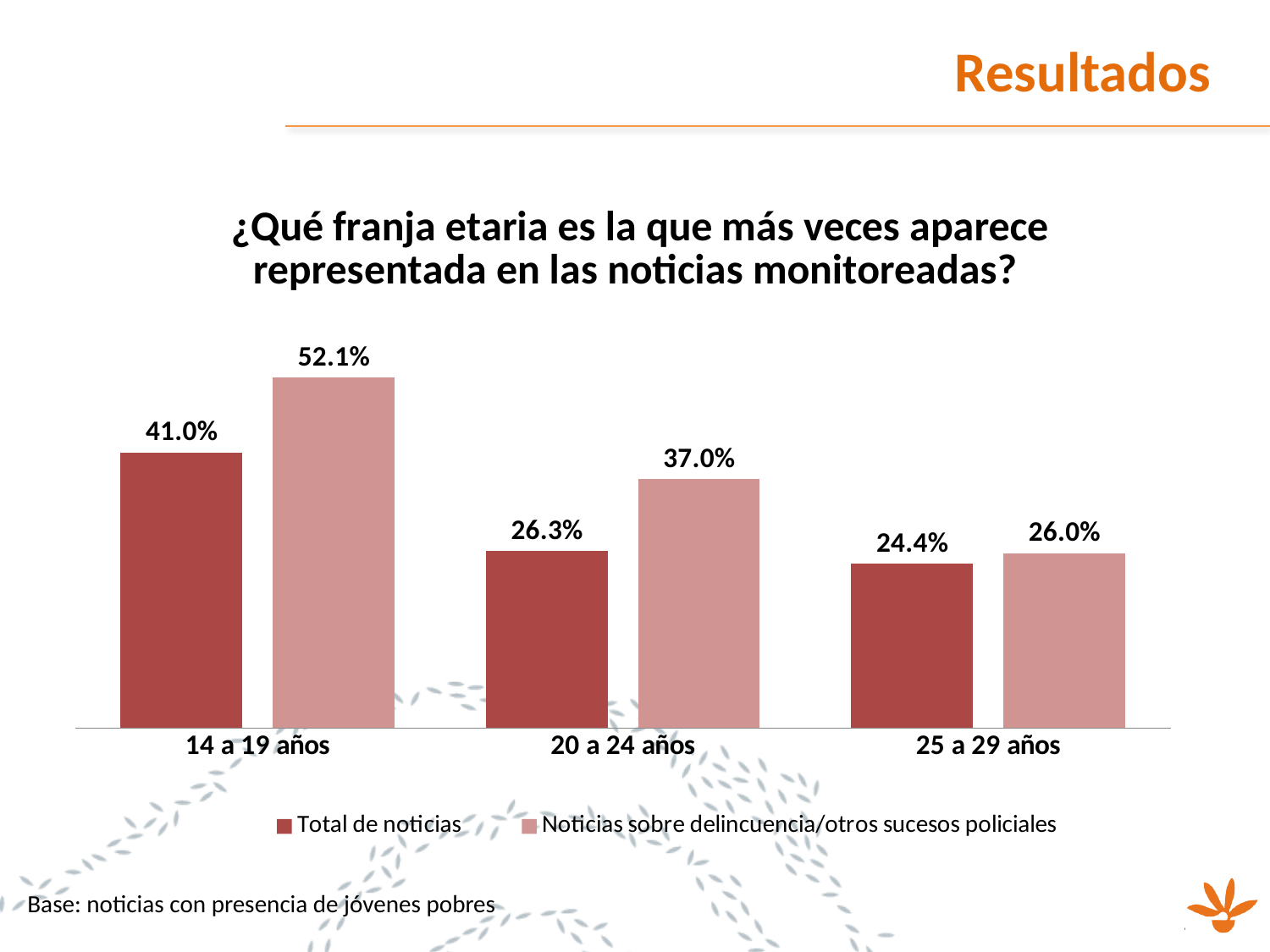
Which is larger in the '25 a 29 años' category: 'Total de noticias' or 'Noticias sobre delincuencia/otros sucesos policiales'? Noticias sobre delincuencia/otros sucesos policiales What kind of chart is shown on the slide? Bar chart What is the value for 'Noticias sobre delincuencia/otros sucesos policiales' in the '20 a 24 años' category? 37.0% What is the value for 'Total de noticias' in the '25 a 29 años' category? 24.4% Which age group has the lowest value for 'Total de noticias'? 25 a 29 años Do the values for 'Total de noticias' rise or fall from '14 a 19 años' to '25 a 29 años'? Fall What is the value for 'Total de noticias' in the '14 a 19 años' category? 41.0% What is the difference between the two series in the '14 a 19 años' category? 11.1% What is the difference between 'Total de noticias' for '14 a 19 años' and for '20 a 24 años'? 14.7% How many age group categories are shown on the x axis? 3 Which age group has the highest value for 'Noticias sobre delincuencia/otros sucesos policiales'? 14 a 19 años How many series does the legend list? 2